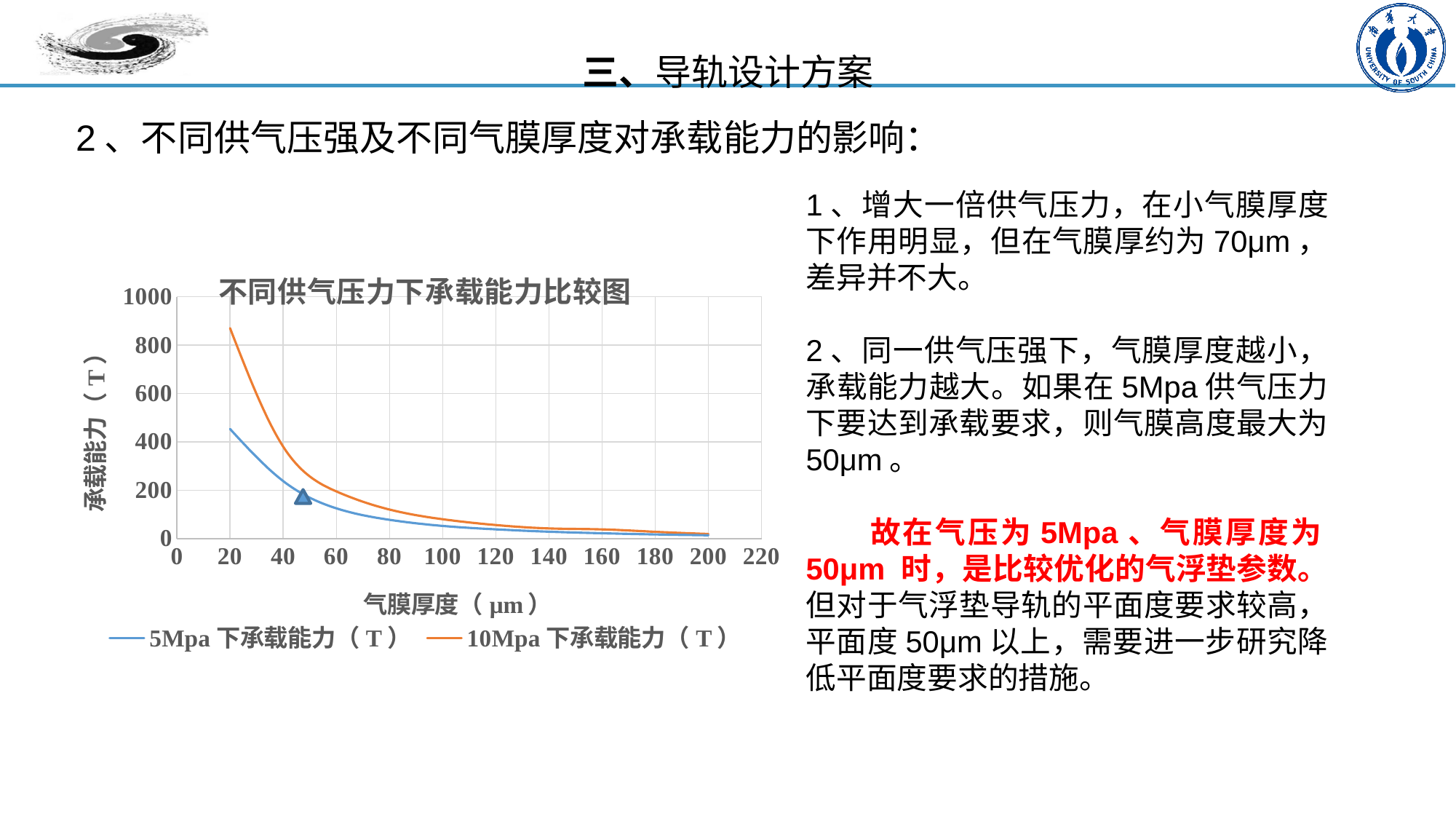
Is the value of 10Mpa 下承载能力（T） at 气膜厚度 200 μm greater or less than 200? less Is the value of 10Mpa 下承载能力（T） at 气膜厚度 20 μm greater or less than 800? greater What kind of chart is shown on the slide? line chart Is the value of 5Mpa 下承载能力（T） at 气膜厚度 100 μm greater or less than 200? less How many series does the legend of the chart list? 2 Do the values of the 5Mpa 下承载能力（T） series rise or fall as 气膜厚度 increases? fall At 气膜厚度 20 μm, which series has the larger 承载能力: 5Mpa 下承载能力（T） or 10Mpa 下承载能力（T）? 10Mpa 下承载能力（T） Which series is drawn in orange in the chart? 10Mpa 下承载能力（T） What is the label of the x axis of the chart? 气膜厚度（μm） Do the values of the 10Mpa 下承载能力（T） series rise or fall as 气膜厚度 increases? fall What is the title of the chart? 不同供气压力下承载能力比较图